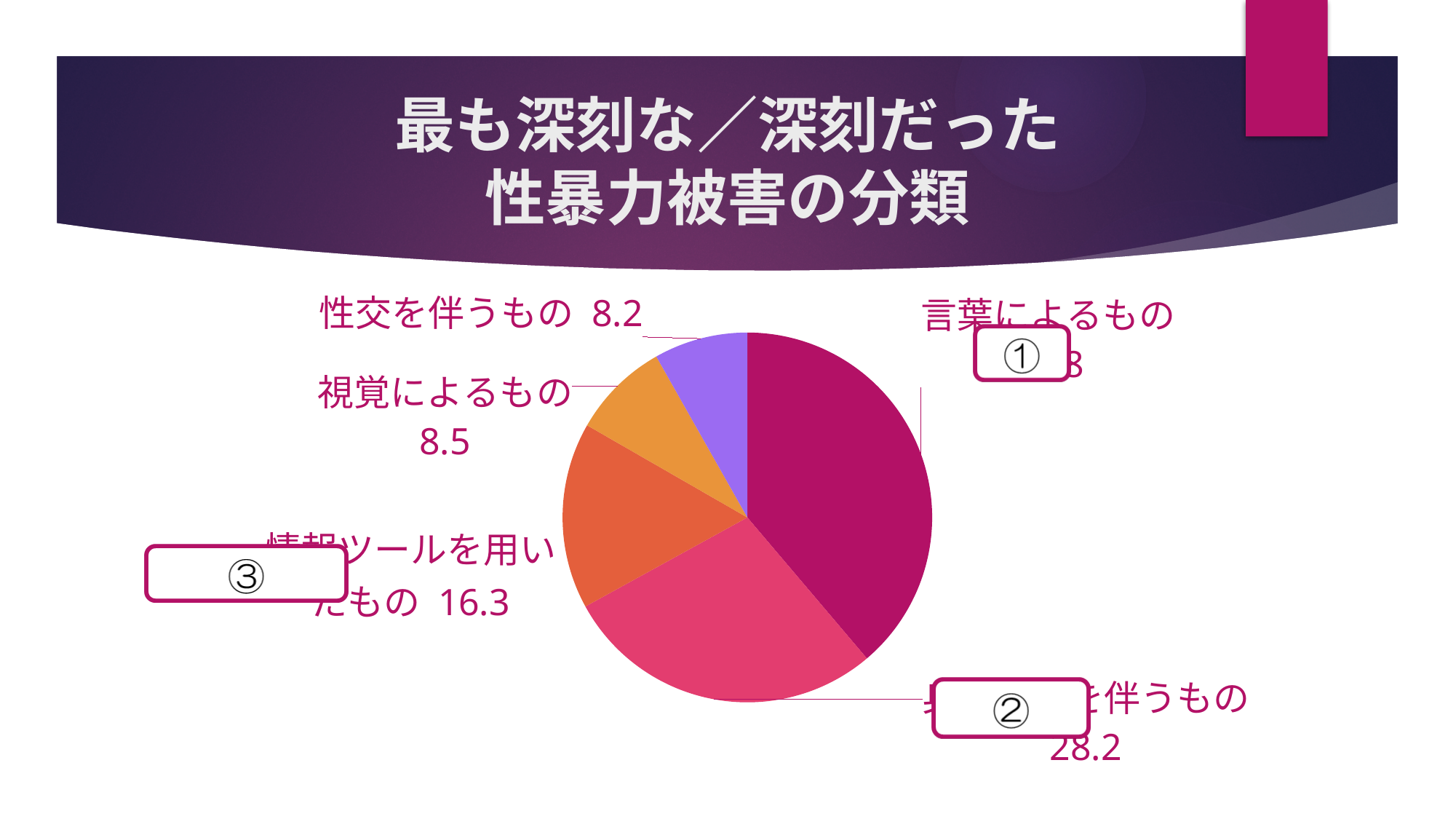
What is the difference between the values for 情報ツールを用いたもの and 視覚によるもの? 7.8 What colour is the slice for 性交を伴うもの? purple How many slices does the pie chart have? 5 What is the value shown for 情報ツールを用いたもの? 16.3 Based on the printed values, which is larger, 視覚によるもの or 性交を伴うもの? 視覚によるもの Which category has the largest slice of the pie? 言葉によるもの What kind of chart is shown on the slide? pie chart What is the value shown for 性交を伴うもの? 8.2 What is the difference between the values for 情報ツールを用いたもの and 性交を伴うもの? 8.1 Which has the larger value, 情報ツールを用いたもの or 視覚によるもの? 情報ツールを用いたもの Which category's label is marked with the circled number ①? 言葉によるもの What is the value shown for 視覚によるもの? 8.5